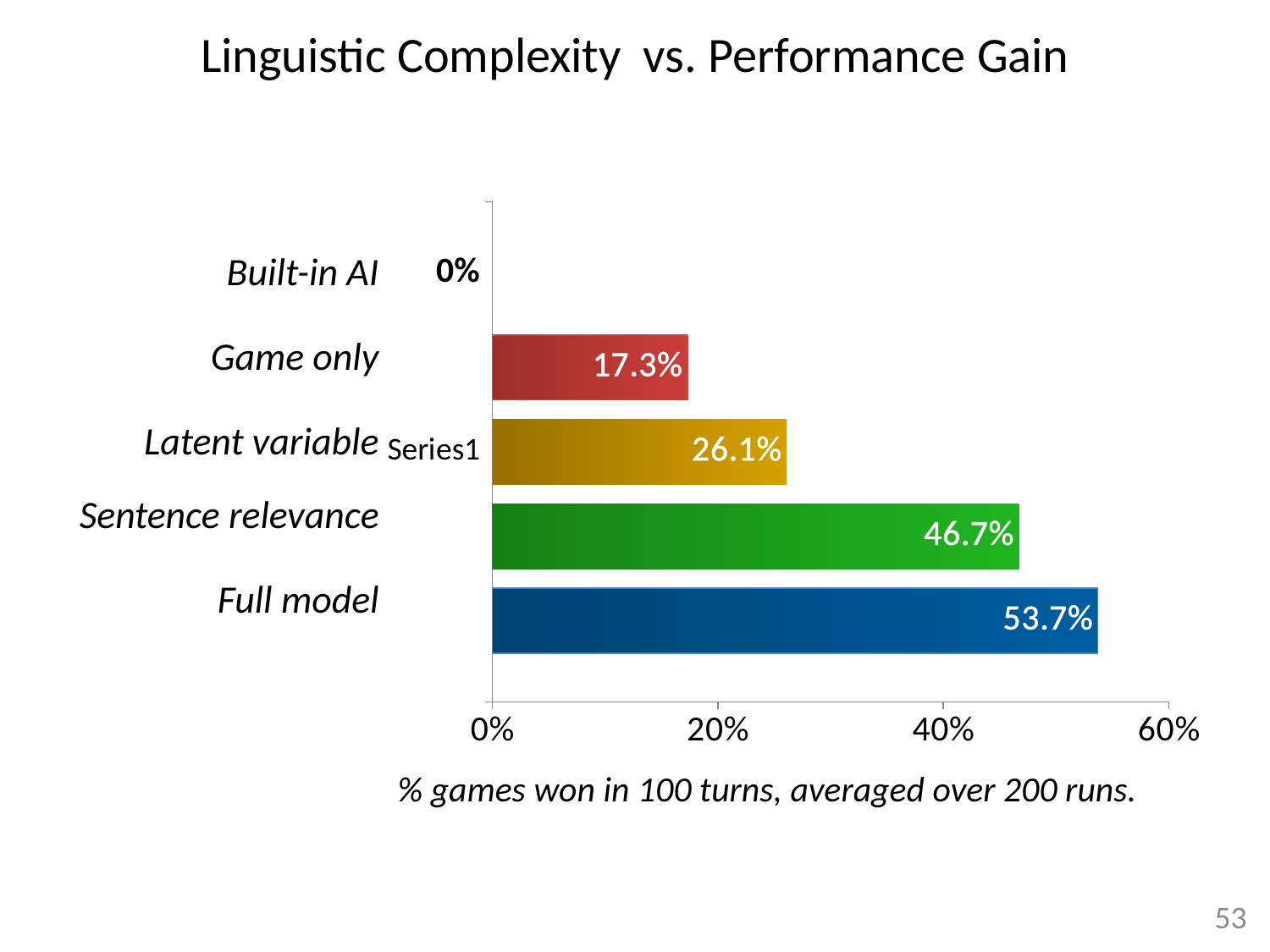
How many categories are shown in the chart? 5 What is the difference between the values for Latent variable and Game only? 8.8% What is the value for Full model? 53.7% What is the difference between the values for Full model and Sentence relevance? 7.0% What kind of chart is shown on the slide? Bar chart Which category has the highest value? Full model What is the value for Game only? 17.3% What is the title of the chart? Linguistic Complexity vs. Performance Gain What is the value for Built-in AI? 0% Which category has the lowest value? Built-in AI Which is larger, the value for Sentence relevance or the value for Latent variable? Sentence relevance What is the value for Latent variable? 26.1%